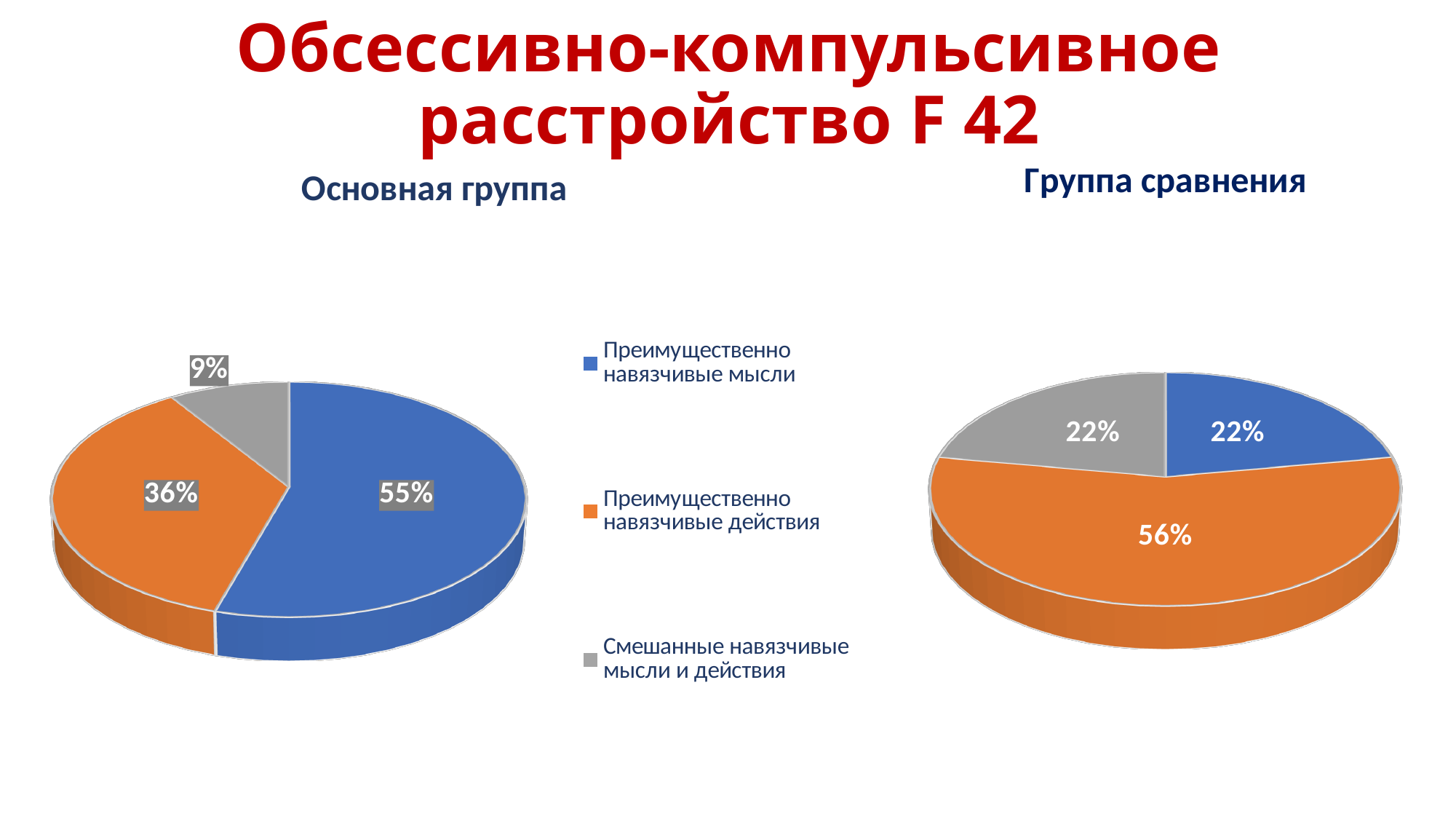
What type of chart is used for "Группа сравнения"? Pie chart How many categories does the legend list for the pie charts? 3 Which is larger: the share for "Преимущественно навязчивые действия" in the "Основная группа" chart or in the "Группа сравнения" chart? Группа сравнения In the "Основная группа" pie chart, which category has the largest slice? Преимущественно навязчивые мысли In the "Основная группа" pie chart, what share is shown for "Преимущественно навязчивые мысли"? 55% In the "Группа сравнения" pie chart, what share is shown for "Преимущественно навязчивые мысли"? 22% In the "Основная группа" pie chart, what share is shown for "Преимущественно навязчивые действия"? 36% In the "Основная группа" pie chart, what is the difference between the shares for "Преимущественно навязчивые мысли" and "Преимущественно навязчивые действия"? 19% In the "Основная группа" pie chart, which category has the smallest slice? Смешанные навязчивые мысли и действия In the "Группа сравнения" pie chart, which category has the largest slice? Преимущественно навязчивые действия In the "Основная группа" pie chart, what share is shown for "Смешанные навязчивые мысли и действия"? 9% In the "Группа сравнения" pie chart, what share is shown for "Преимущественно навязчивые действия"? 56%